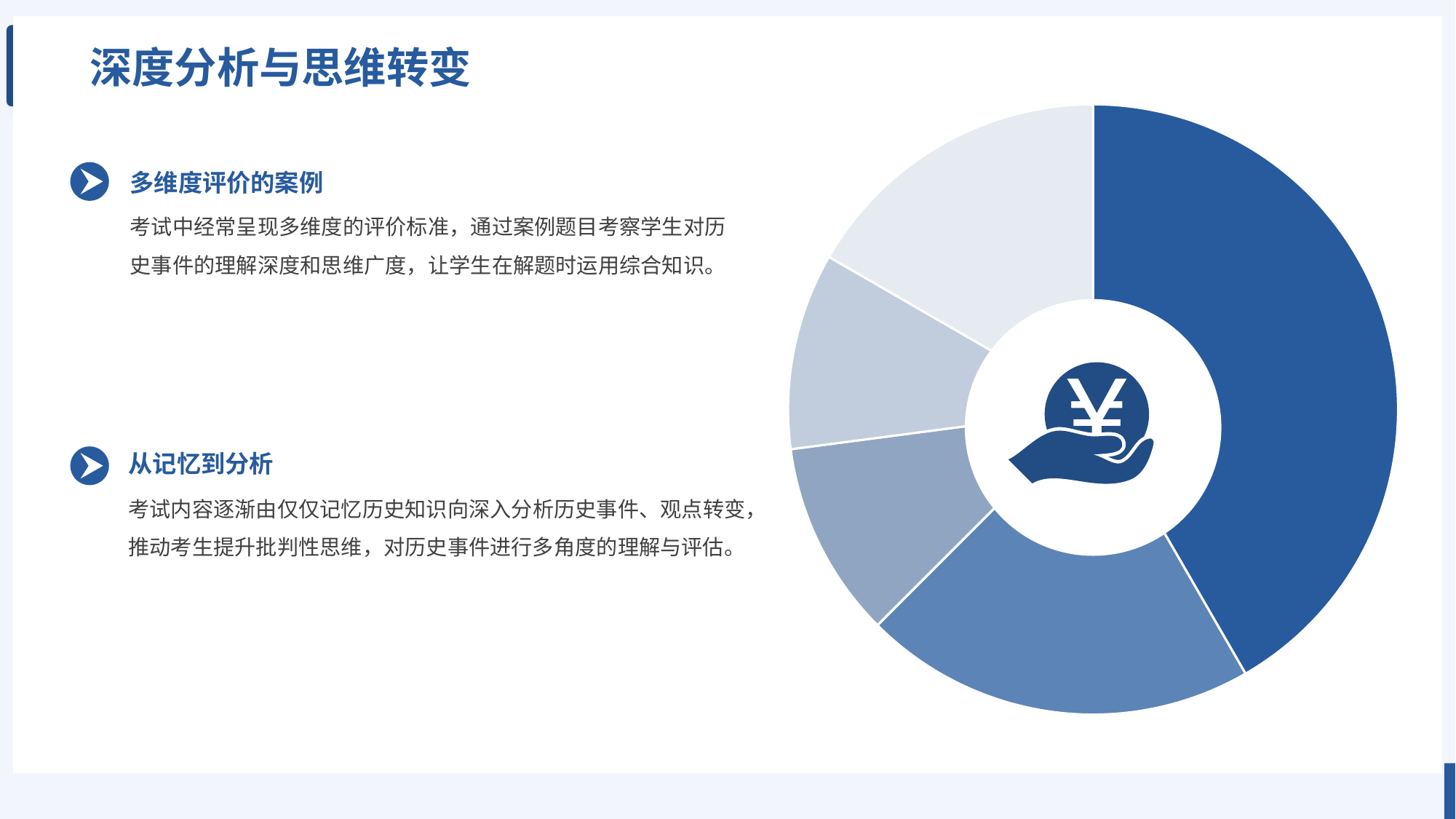
Does the doughnut chart on the slide display a legend? No Which slice of the doughnut chart is the largest? The dark blue slice on the right How many slices does the doughnut chart on the slide have? 5 What symbol appears in the centre of the doughnut chart? A yen/yuan (¥) coin held in a hand What kind of chart is shown on the right side of the slide? Doughnut chart